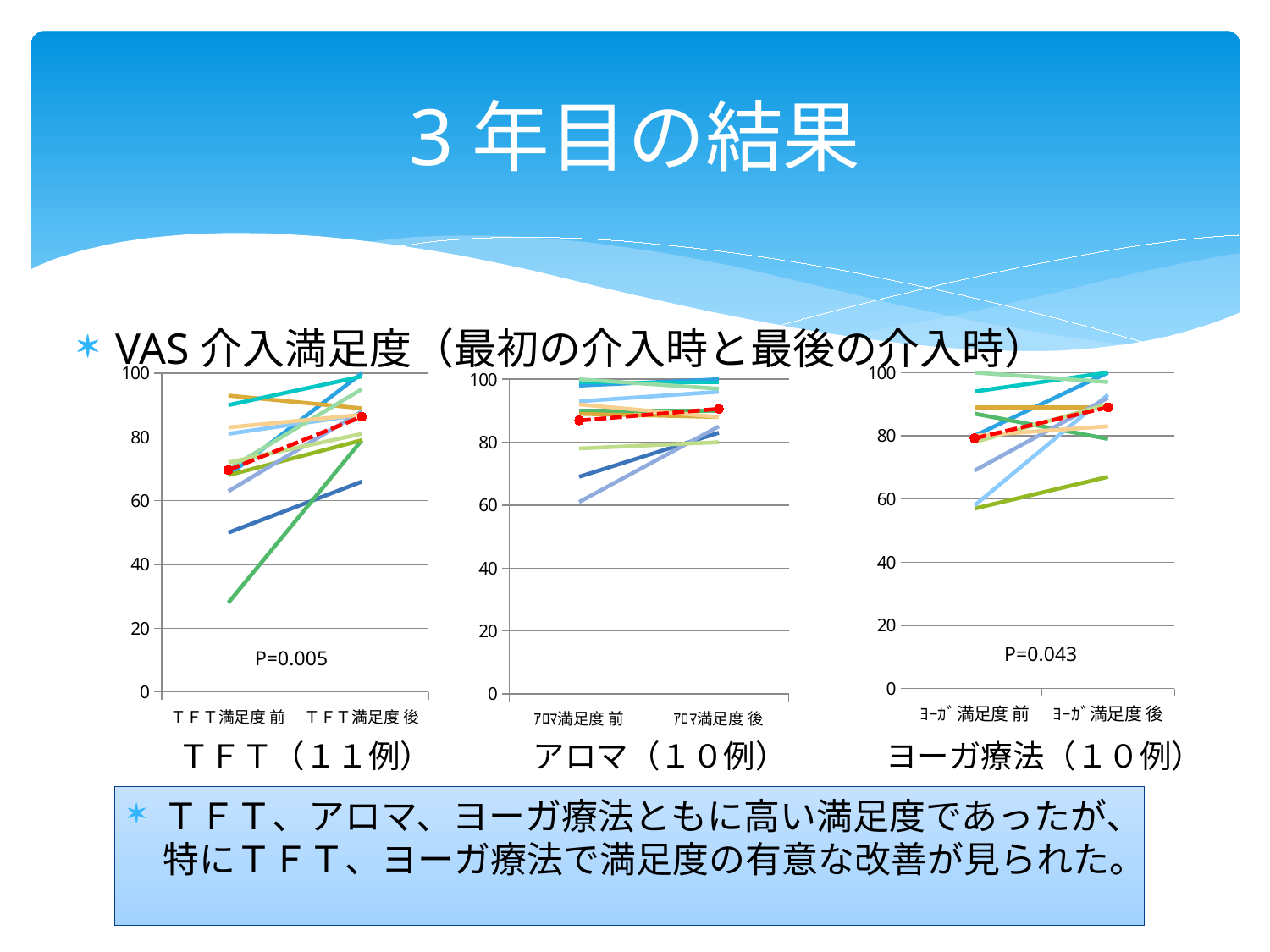
In the ヨーガ療法 (10例) chart, is the red dashed line's value at ヨーガ満足度 後 greater or less than 80? greater What P-value is printed on the ヨーガ療法 (10例) chart? P=0.043 In the TFT (11例) chart, is the red dashed line's value at ＴＦＴ満足度 前 greater or less than 60? greater In the ヨーガ療法 (10例) chart, does the red dashed line rise or fall from ヨーガ満足度 前 to ヨーガ満足度 後? rises In the アロマ (10例) chart, is the red dashed line's value at アロマ満足度 前 greater or less than 80? greater In the TFT (11例) chart, does the red dashed line rise or fall from ＴＦＴ満足度 前 to ＴＦＴ満足度 後? rises How many x-axis categories does the アロマ (10例) chart in the middle have? 2 What kind of chart is the TFT (11例) chart on the left? line chart What P-value is printed on the TFT (11例) chart? P=0.005 In the アロマ (10例) chart, is the red dashed line higher at アロマ満足度 前 or at アロマ満足度 後? アロマ満足度 後